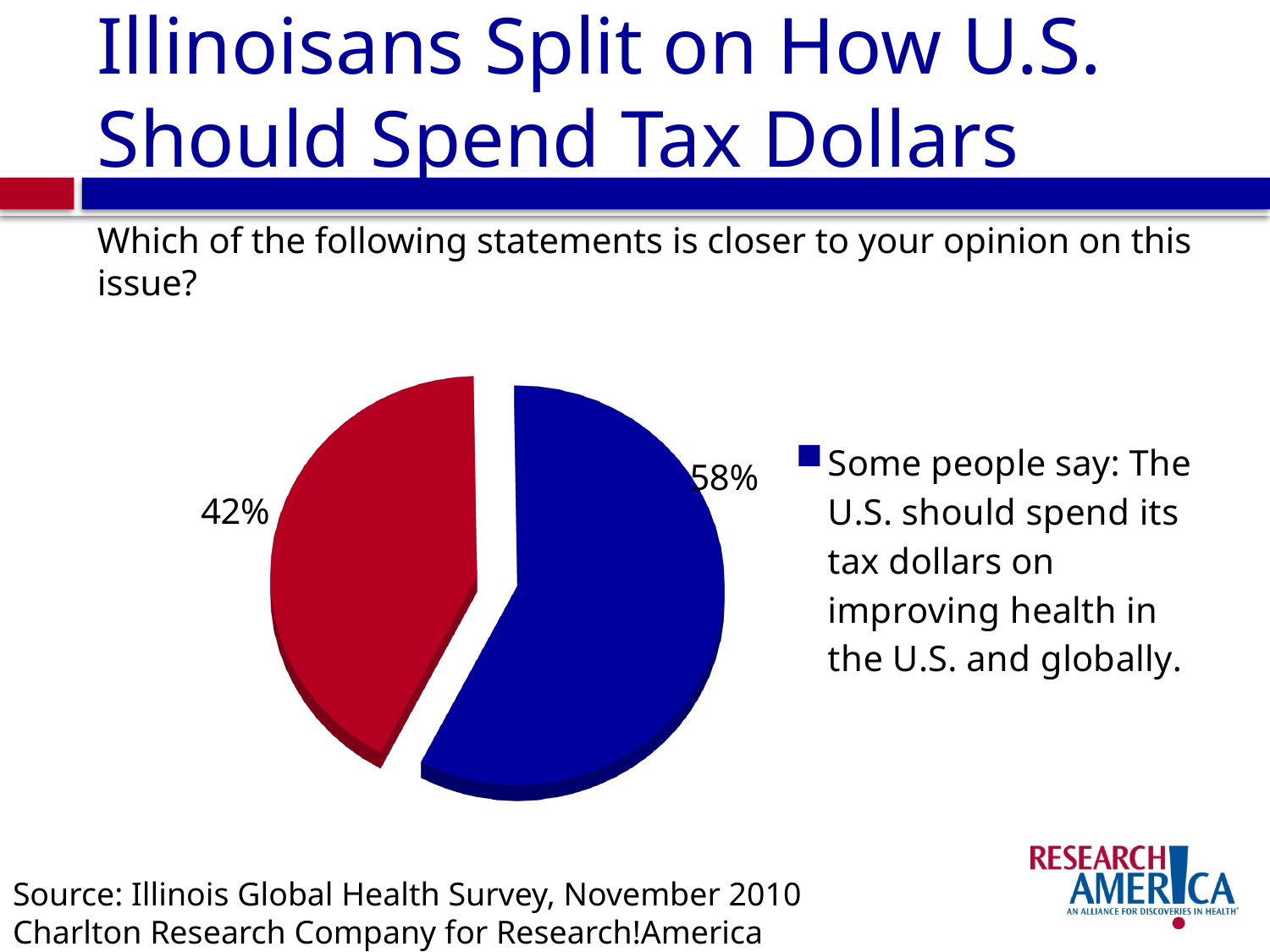
Which slice of the pie chart is the largest? the blue slice (58%) How many slices does the pie chart have? 2 What do the two labelled slices of the pie chart add up to? 100% What kind of chart is shown on the slide? pie chart What percentage of respondents chose the statement "The U.S. should spend its tax dollars on improving health in the U.S. and globally"? 58% What survey question is shown above the pie chart? Which of the following statements is closer to your opinion on this issue? What is the difference in percentage points between the blue slice and the red slice? 16 percentage points What colour is the slice for the legend entry "Some people say: The U.S. should spend its tax dollars on improving health in the U.S. and globally"? blue Which slice of the pie chart is the smallest? the red slice (42%) What value is shown for the red slice of the pie chart? 42% Which is larger, the blue slice or the red slice? the blue slice What share of the pie does the slice for "The U.S. should spend its tax dollars on improving health in the U.S. and globally" represent? 58%